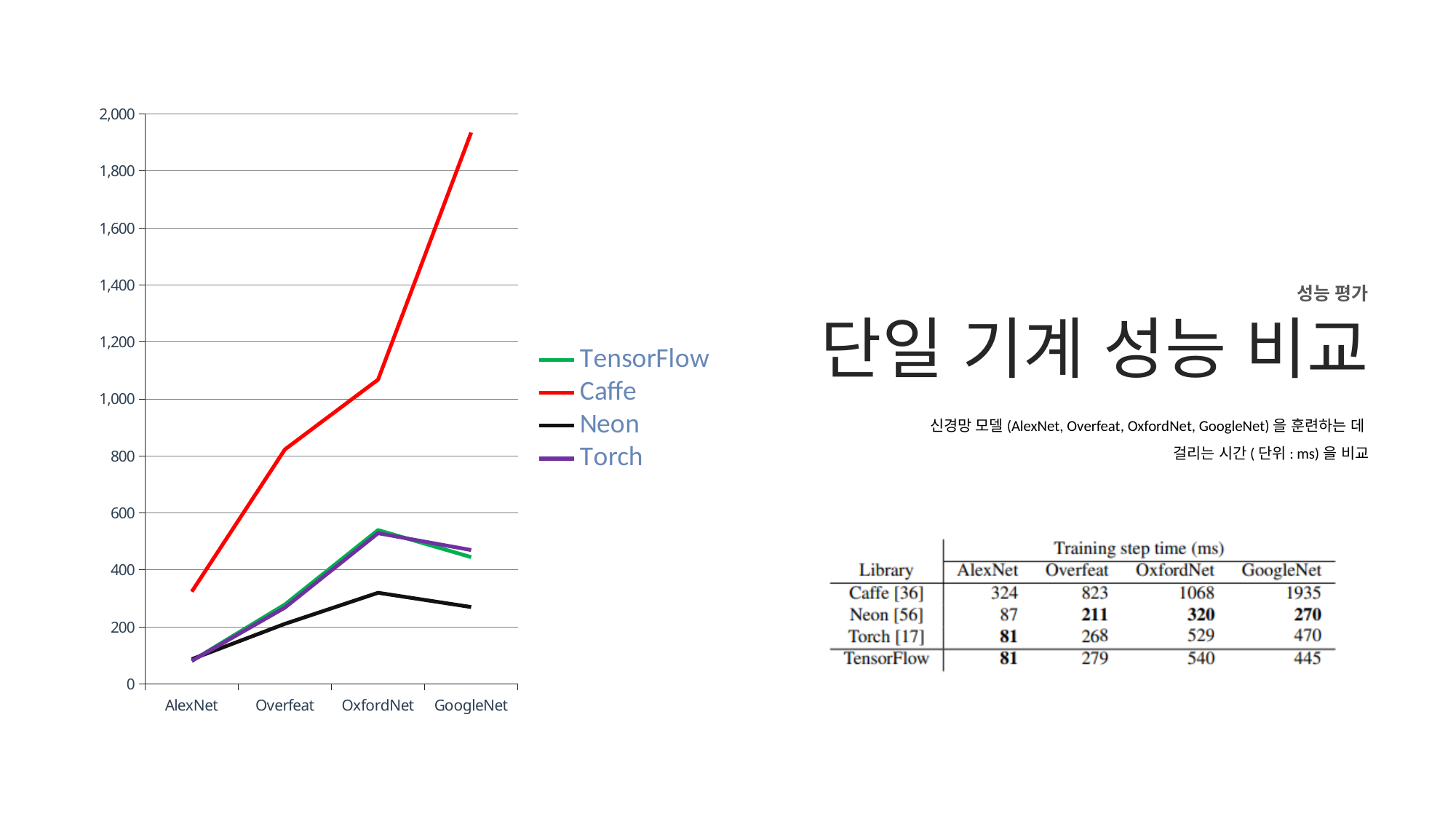
According to the table on the slide, what is the difference between Caffe's GoogleNet time and its OxfordNet time? 867 Which library has the highest value for GoogleNet in the chart? Caffe Is the value for Caffe at GoogleNet greater or less than 1,800? greater What kind of chart is shown on the left of the slide? line chart According to the table on the slide, what is the training step time for Caffe on GoogleNet? 1935 How many series does the chart's legend list? 4 Which library has the lowest value for OxfordNet in the chart? Neon How many categories are shown along the x axis of the chart? 4 Which is larger at Overfeat, the value for Caffe or the value for Neon? Caffe Does the Caffe line rise or fall from AlexNet to GoogleNet? rises What colour is the Caffe line in the chart? red Is the value for Neon at OxfordNet greater or less than 400? less